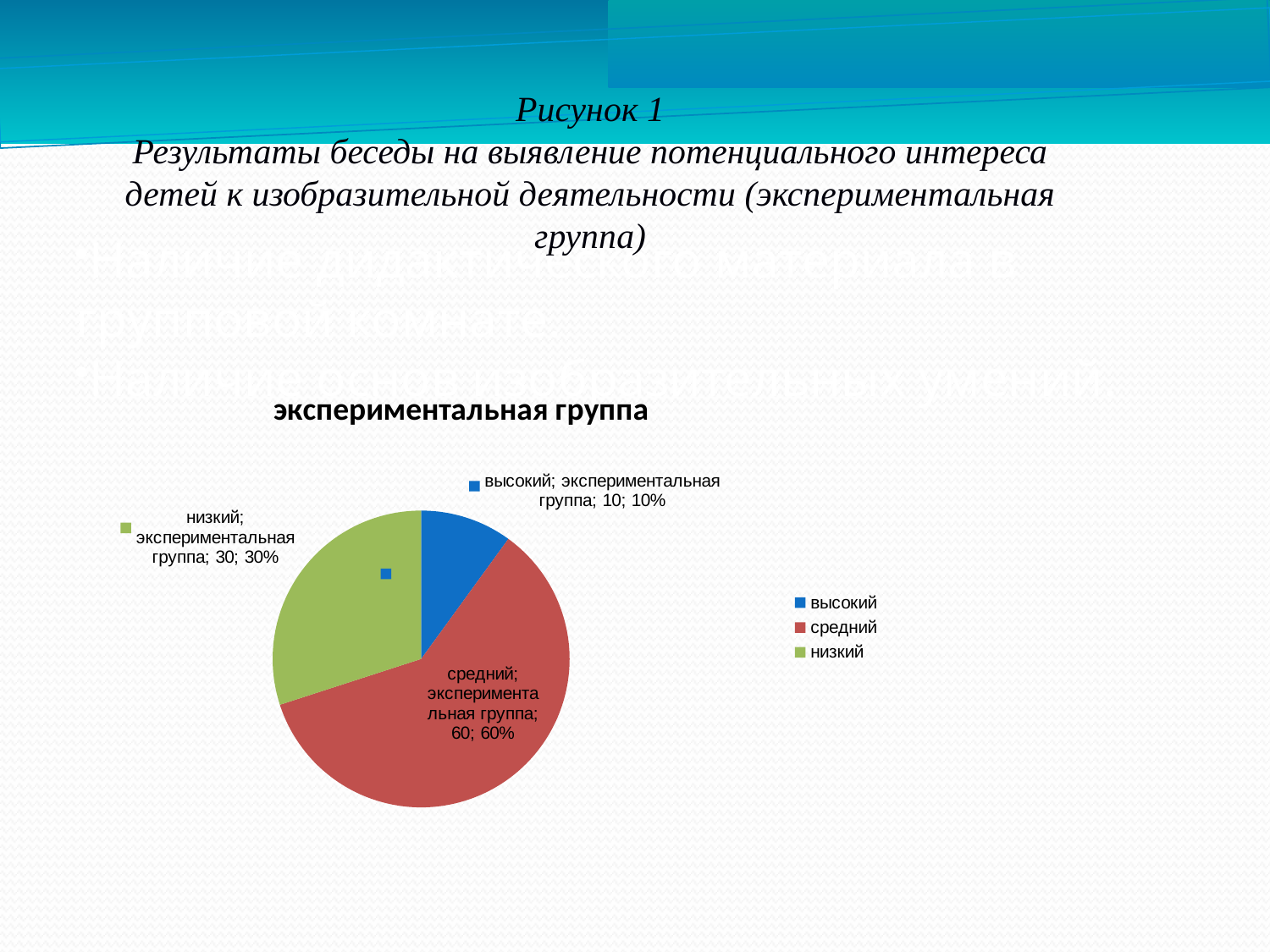
How many entries does the legend list? 3 What value is shown for the 'средний' slice? 60 What share of the pie does the 'средний' slice represent? 60% What kind of chart is shown on the slide? pie chart How many slices does the pie chart have? 3 Which category has the smallest slice? высокий What share of the pie does the 'низкий' slice represent? 30% What is the difference between the values for 'средний' and 'низкий'? 30 What value is shown for the 'высокий' slice? 10 What value is shown for the 'низкий' slice? 30 What is the title of the chart? экспериментальная группа Which category has the largest slice? средний